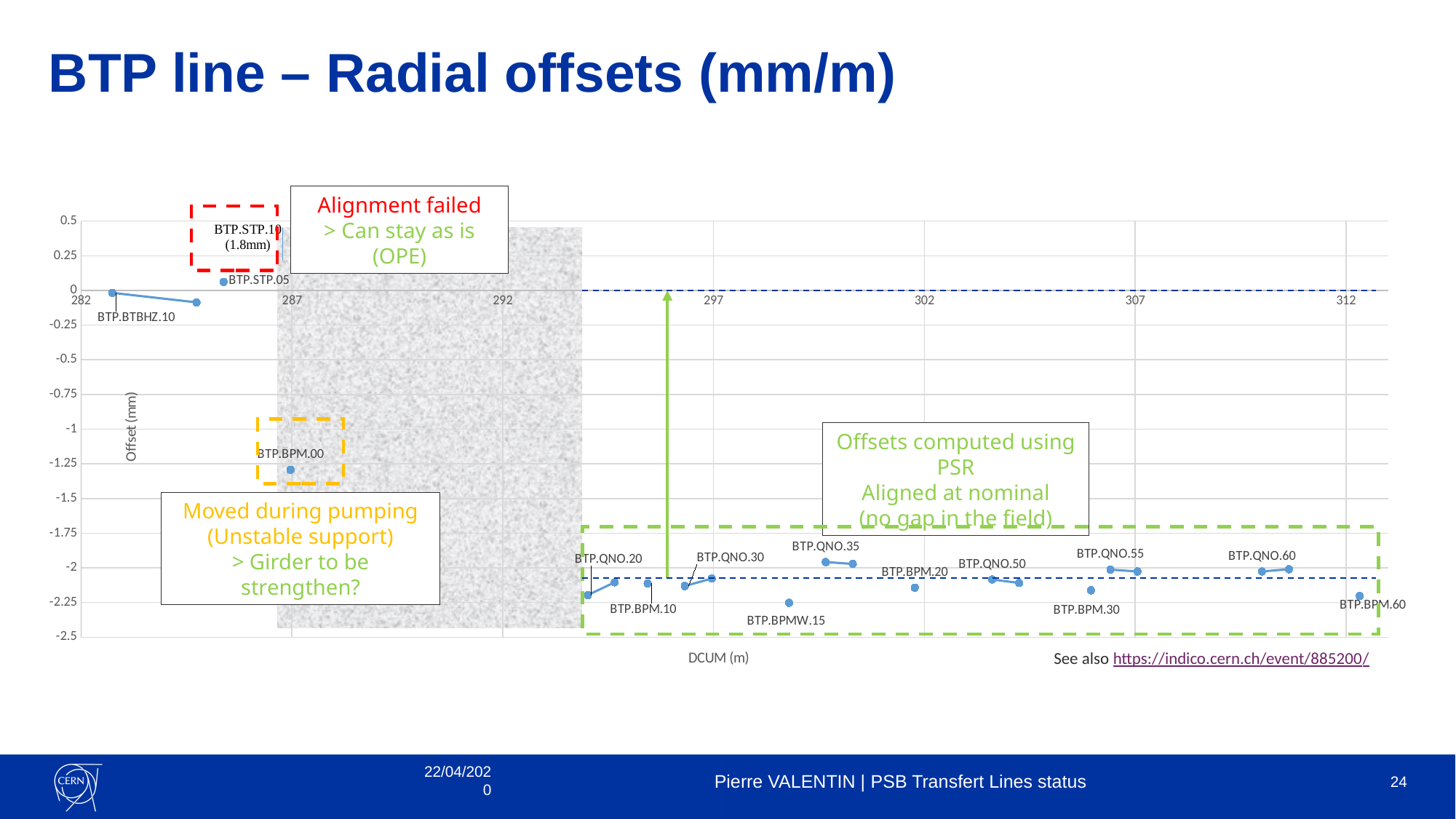
Is the offset for BTP.BPM.60 greater or less than -2? less Is the offset for BTP.BPM.00 greater or less than -1.5? greater Which element is annotated with the value (1.8mm) on the chart? BTP.STP.10 What is the label of the y axis of the chart? Offset (mm) Is the offset for BTP.BPMW.15 greater or less than -2? less Which has the larger offset, BTP.BPM.00 or BTP.BPMW.15? BTP.BPM.00 What kind of chart is shown on the slide? scatter chart Which has the larger offset, BTP.STP.05 or BTP.BPM.00? BTP.STP.05 What is the label of the x axis of the chart? DCUM (m) What is the lowest value shown on the y axis of the chart? -2.5